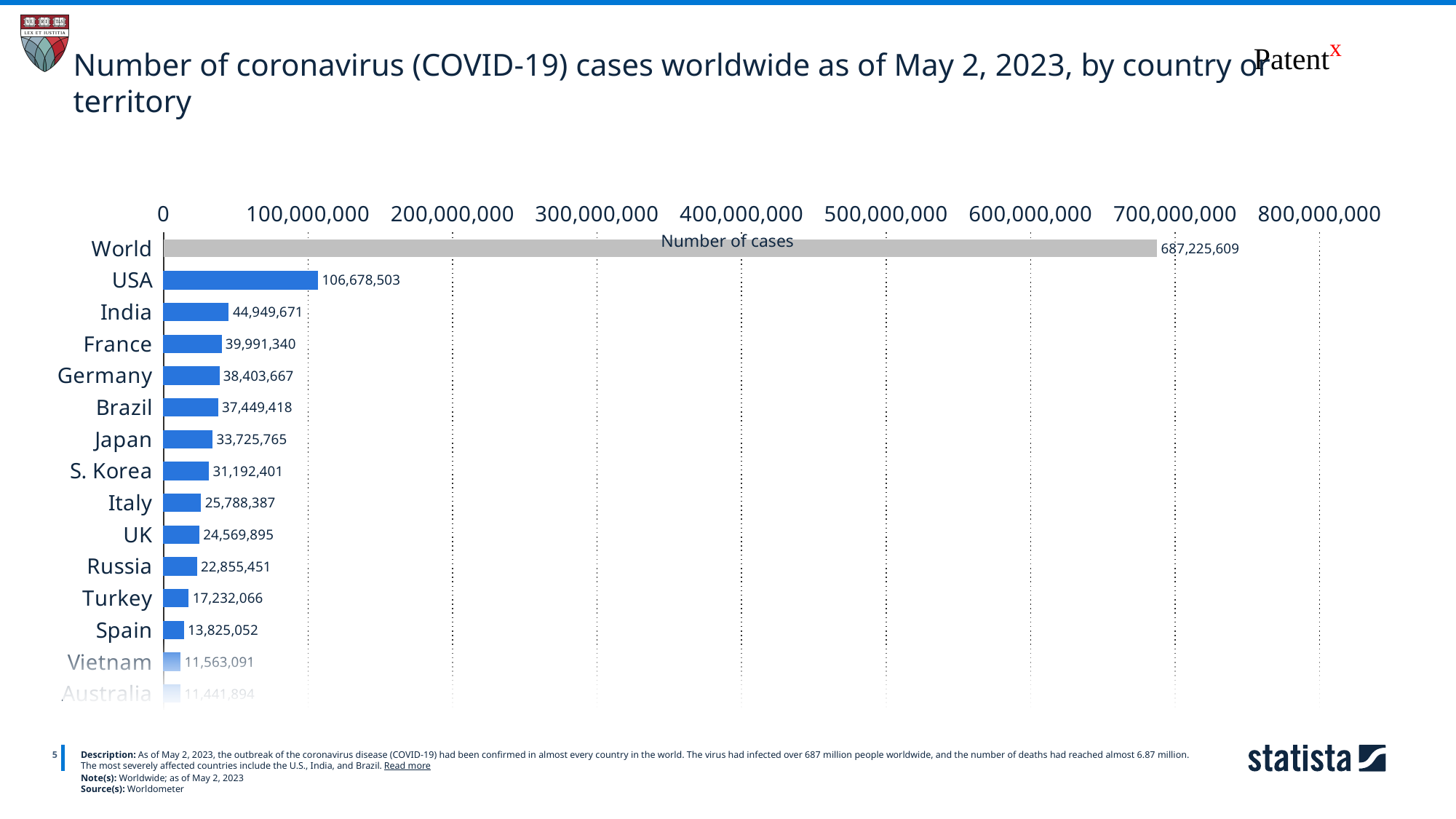
What is the number of cases for India? 44,949,671 What is the number of cases for Turkey? 17,232,066 Excluding the World bar, which country has the highest number of cases? USA Which has more cases, Japan or S. Korea? Japan What is the number of cases for the USA? 106,678,503 Is the value for the USA greater or less than 100,000,000? greater What is the number of cases for the World? 687,225,609 What is the difference in cases between the USA and India? 61,728,832 What is the label shown on the value axis of the chart? Number of cases What is the difference in cases between France and Germany? 1,587,673 What kind of chart is shown on the slide? bar chart What is the number of cases for Brazil? 37,449,418